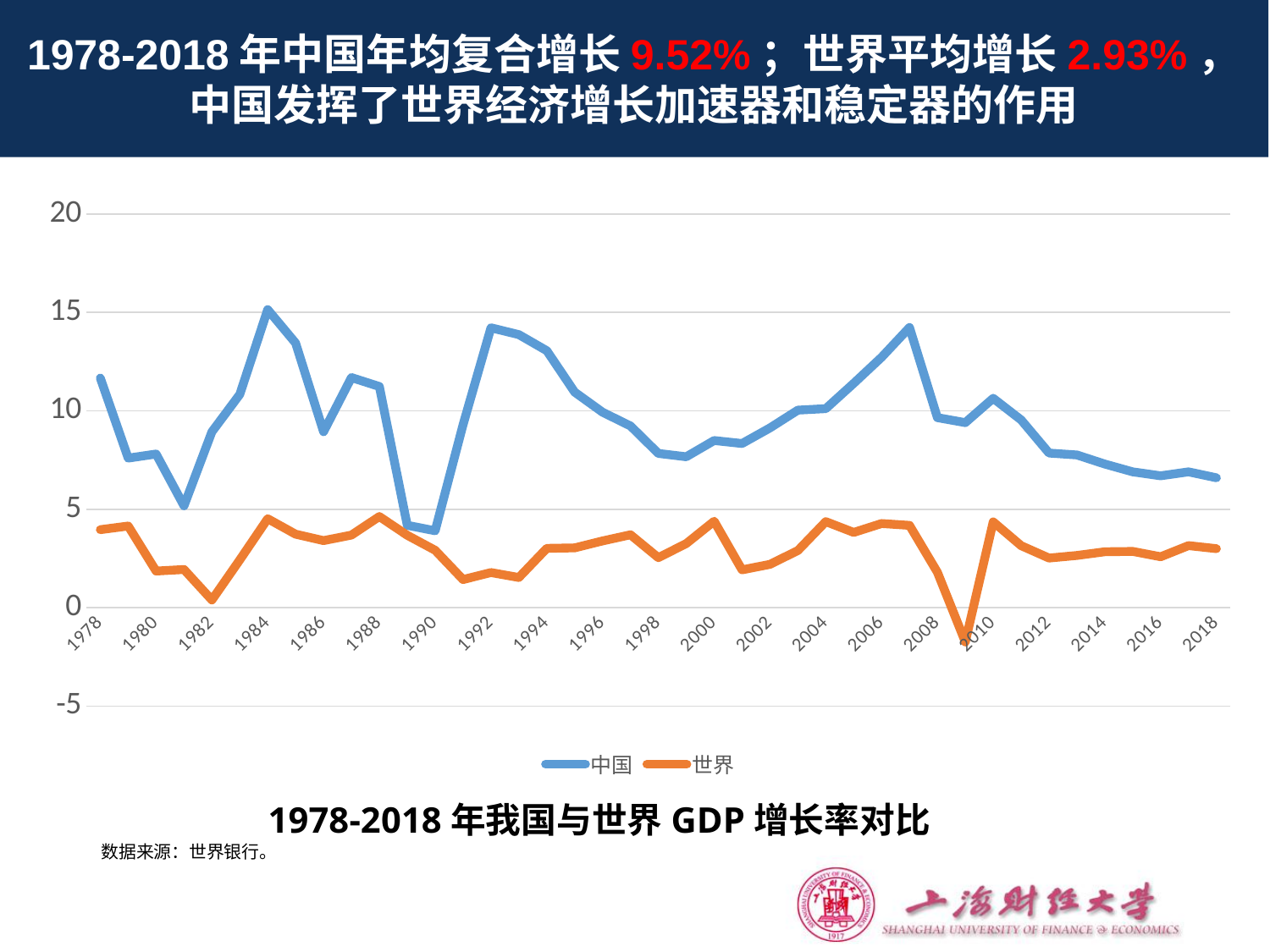
What is the title printed below the chart? 1978-2018年我国与世界GDP增长率对比 In which year does the 世界 series reach its lowest value? 2009 Is the value for 中国 in 1984 greater or less than 10? greater Is the value for 中国 in 1990 greater or less than 5? less Is the value for 世界 in 2009 greater or less than 0? less Does the 中国 series rise or fall from 2010 to 2018? fall In 2018, which series has the larger value, 中国 or 世界? 中国 In which year does the 中国 series reach its highest value? 1984 What are the two series named in the legend? 中国 and 世界 How many series does the legend list? 2 What kind of chart is shown on the slide? line chart